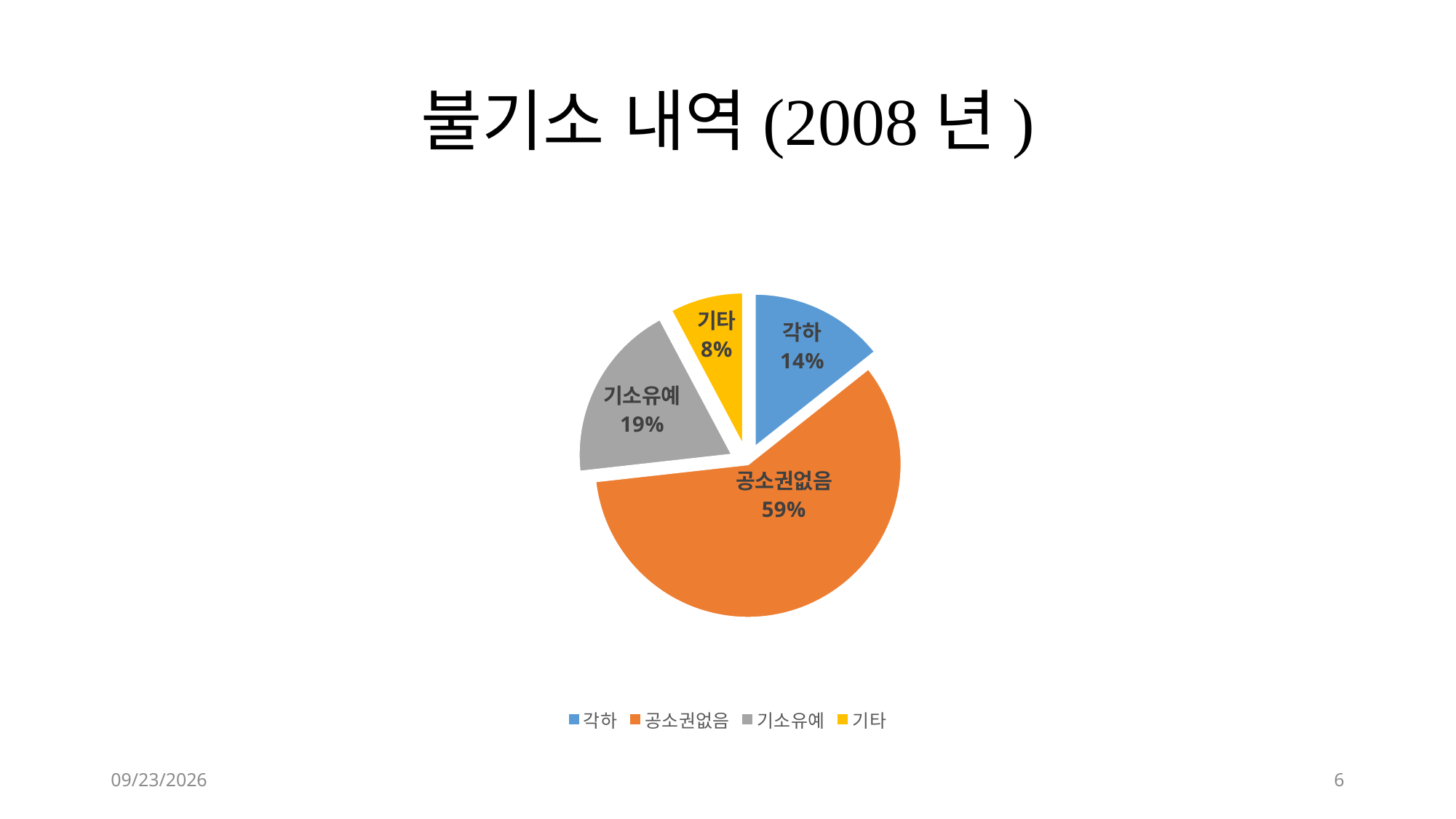
What share of the pie does 기타 represent? 8% What kind of chart is shown on the slide? Pie chart What share of the pie does 기소유예 represent? 19% What is the difference in percentage points between 공소권없음 and 기소유예? 40% How many categories are shown in the pie chart? 4 What share of the pie does 각하 represent? 14% Which is larger, the share for 각하 or the share for 기타? 각하 Which category has the largest slice of the pie? 공소권없음 What is the title of the slide containing the chart? 불기소 내역 (2008 년 ) What is the difference in percentage points between 기소유예 and 각하? 5% Which category has the smallest slice of the pie? 기타